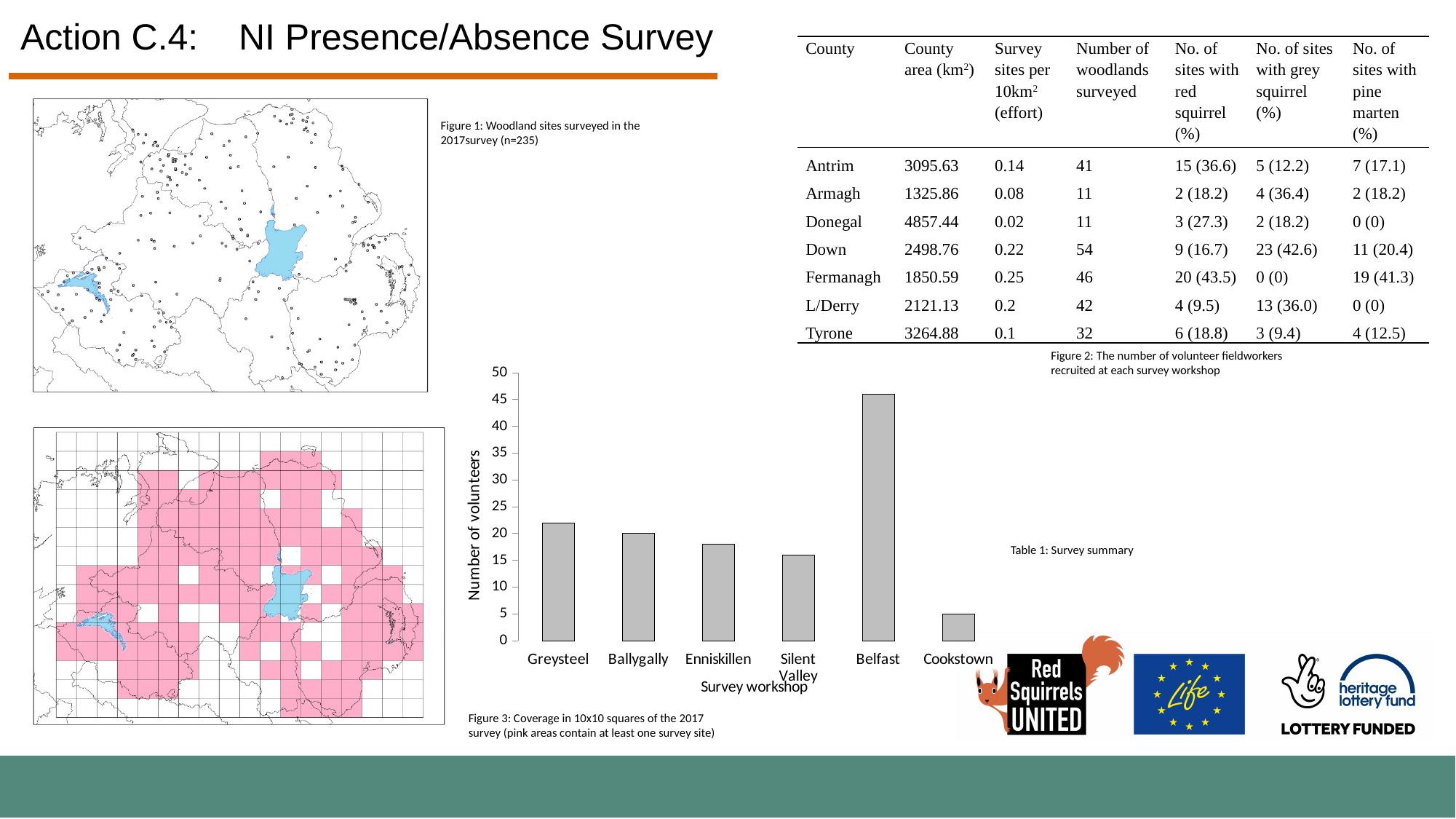
In the volunteer fieldworkers bar chart, is the number of volunteers for Cookstown greater or less than 10? less How many survey workshops are shown on the x axis of the volunteer fieldworkers bar chart? 6 In the volunteer fieldworkers bar chart, is the number of volunteers for Silent Valley greater or less than 20? less In the volunteer fieldworkers bar chart, which survey workshop recruited the fewest volunteers? Cookstown In the volunteer fieldworkers bar chart, which workshop recruited more volunteers, Greysteel or Silent Valley? Greysteel In the volunteer fieldworkers bar chart, is the number of volunteers for Belfast greater or less than 40? greater In the volunteer fieldworkers bar chart, which workshop recruited more volunteers, Belfast or Ballygally? Belfast In the volunteer fieldworkers bar chart, which survey workshop recruited the most volunteers? Belfast What is the label on the horizontal axis of the volunteer fieldworkers bar chart? Survey workshop What kind of chart is Figure 2 (the number of volunteer fieldworkers recruited at each survey workshop)? bar chart What is the label on the vertical axis of the volunteer fieldworkers bar chart? Number of volunteers